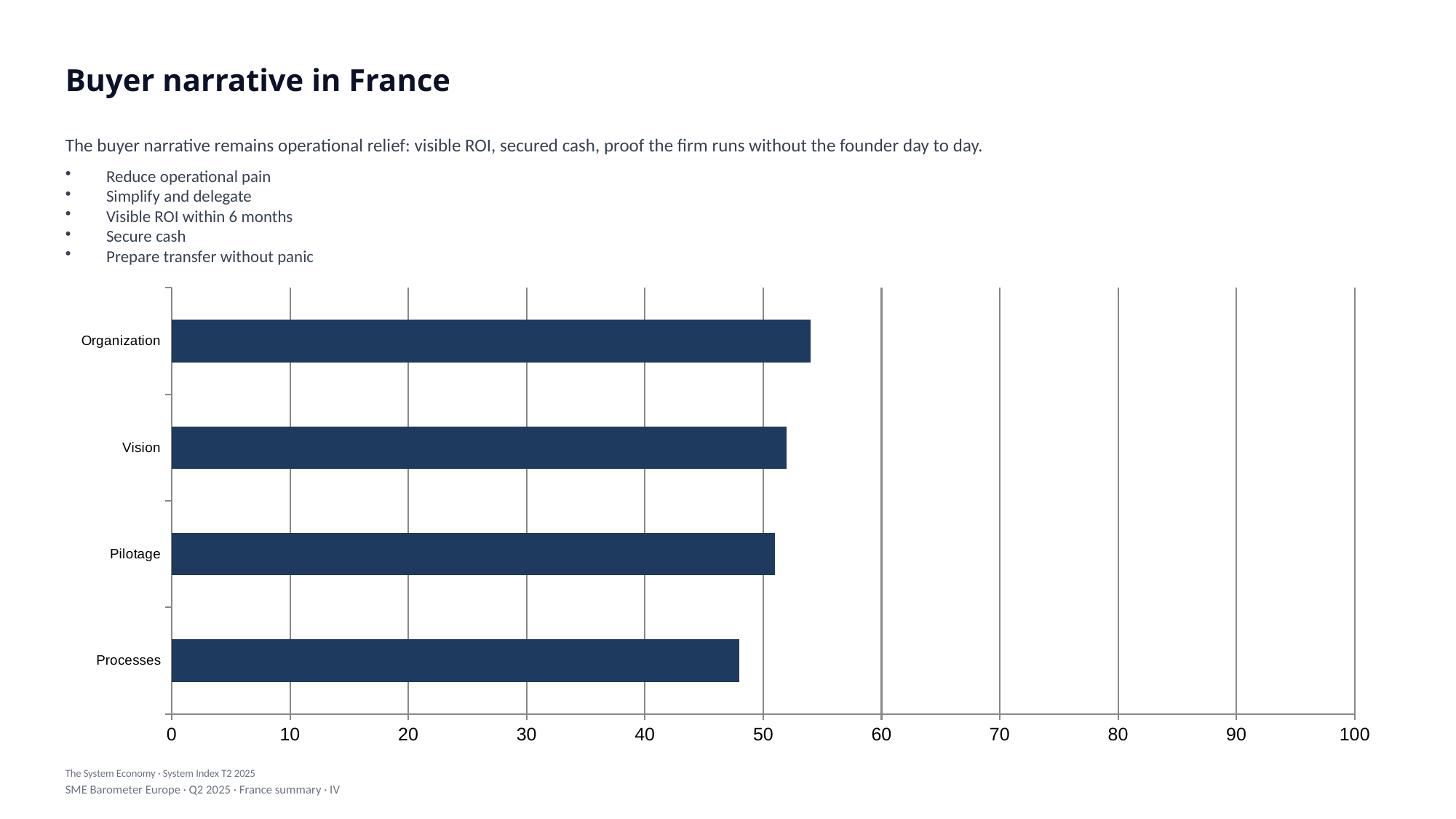
Is the value for Vision greater or less than 60? less What kind of chart is shown on the slide? bar chart Which is larger, the value for Organization or the value for Processes? Organization What is the title of the slide containing the chart? Buyer narrative in France Which category has the highest value in the chart? Organization What is the maximum value shown on the horizontal axis of the chart? 100 Is the value for Processes greater or less than 50? less Which category has the lowest value in the chart? Processes Is the value for Pilotage greater or less than 40? greater Which is larger, the value for Vision or the value for Processes? Vision How many categories are plotted in the chart? 4